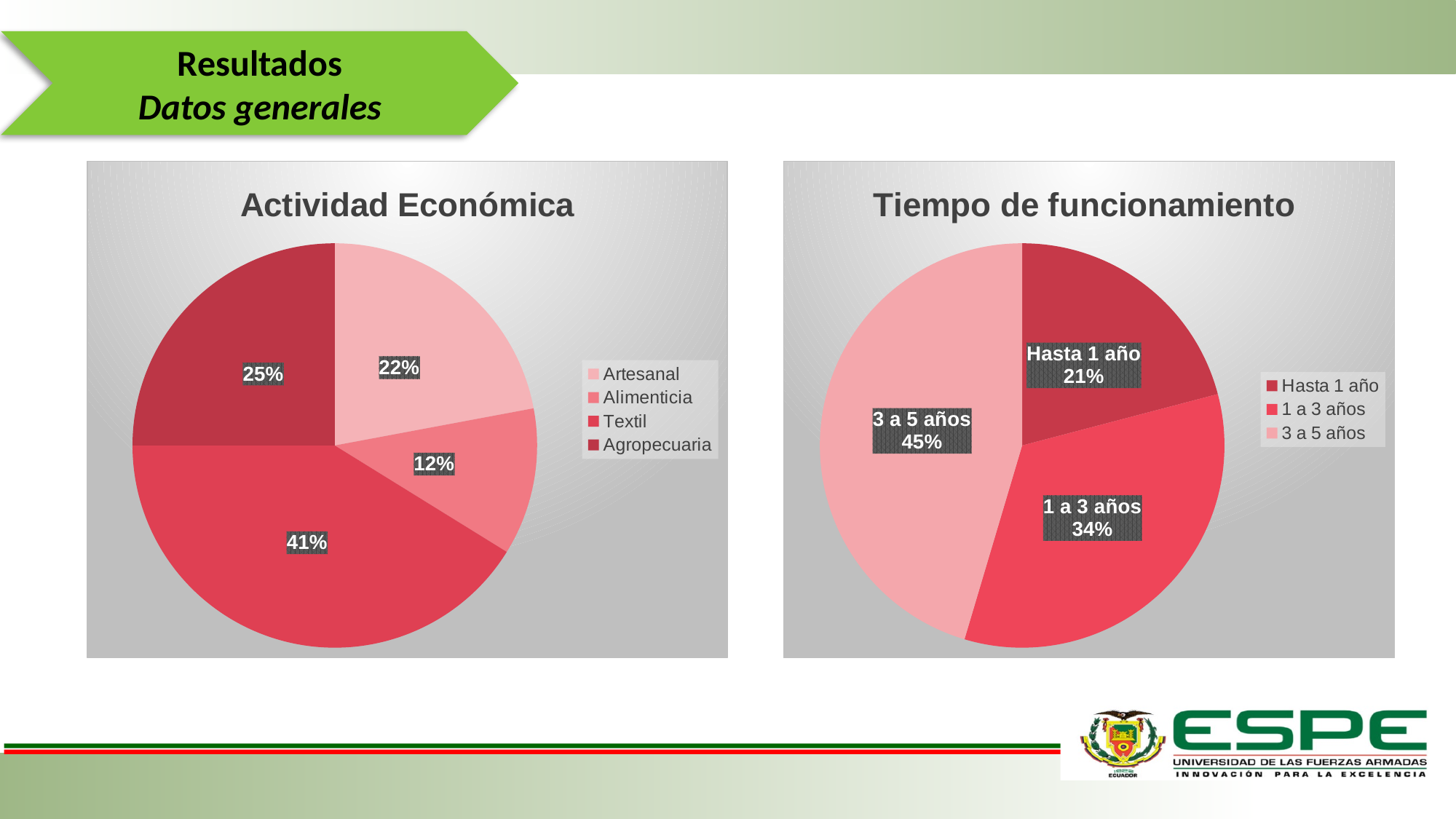
In the 'Actividad Económica' chart, which category has the largest share? Textil In the 'Actividad Económica' chart, what share does Textil have? 41% In the 'Tiempo de funcionamiento' chart, which category has the smallest share? Hasta 1 año What type of chart is the 'Tiempo de funcionamiento' chart? Pie chart In the 'Actividad Económica' chart, how many categories are shown? 4 In the 'Tiempo de funcionamiento' chart, which category has the largest share? 3 a 5 años In the 'Tiempo de funcionamiento' chart, what share does '1 a 3 años' have? 34% In the 'Tiempo de funcionamiento' chart, what is the difference between the '3 a 5 años' and 'Hasta 1 año' shares? 24% How many entries does the legend of the 'Tiempo de funcionamiento' chart list? 3 In the 'Actividad Económica' chart, what is the difference between the Agropecuaria and Artesanal shares? 3% In the 'Actividad Económica' chart, what share does Alimenticia have? 12% In the 'Actividad Económica' chart, which category has the smallest share? Alimenticia